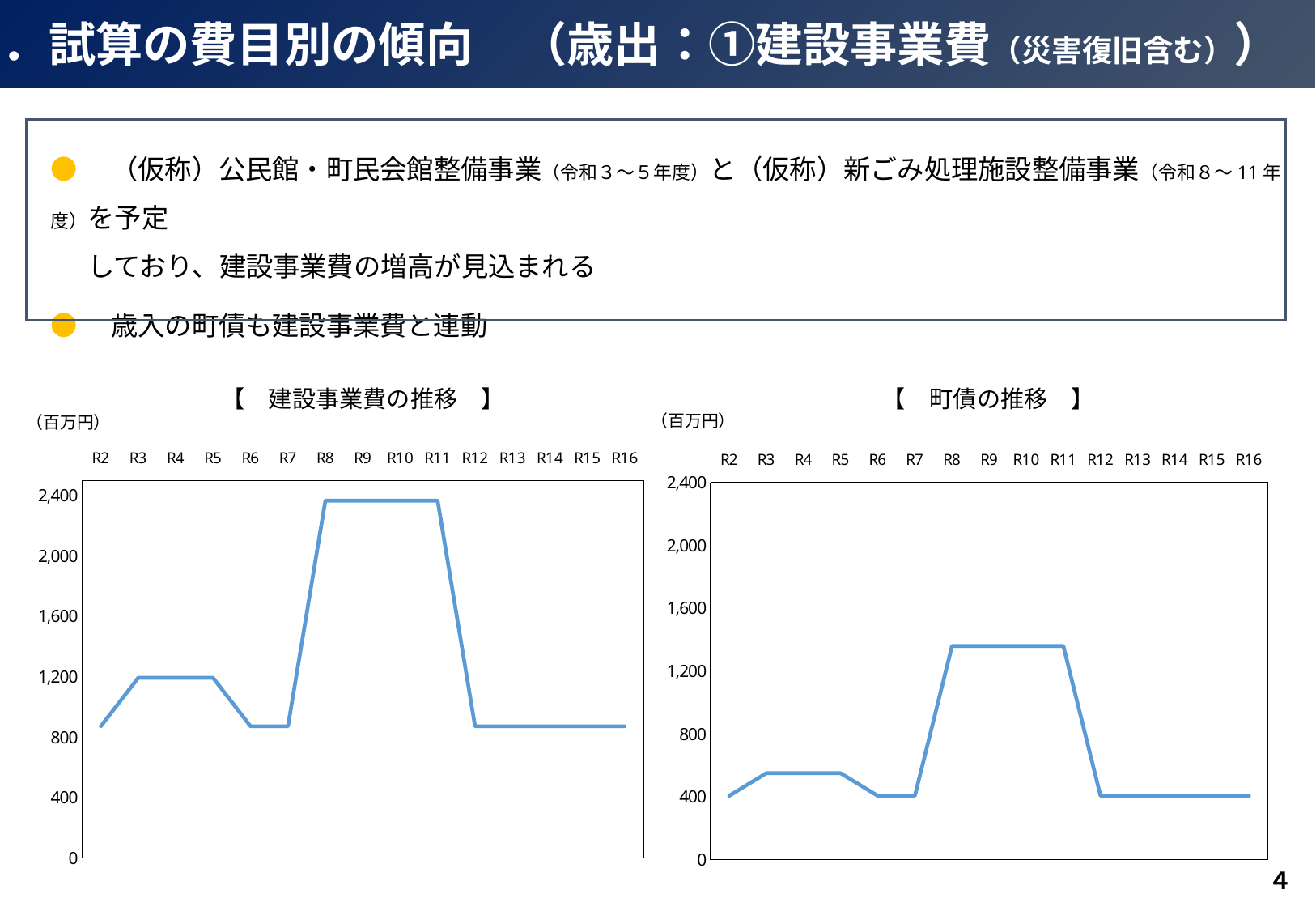
What kind of chart is the right chart titled 町債の推移? line chart In the left chart (建設事業費の推移), is the value for R2 greater or less than 1,200? less In the right chart (町債の推移), does the value rise or fall from R7 to R8? rise In the right chart (町債の推移), is the value for R14 greater or less than 800? less In the right chart (町債の推移), which is larger, the value for R4 or the value for R6? R4 What kind of chart is the left chart titled 建設事業費の推移? line chart In the left chart (建設事業費の推移), is the value for R9 greater or less than 2,000? greater In the left chart (建設事業費の推移), which is larger, the value for R4 or the value for R7? R4 In the left chart (建設事業費の推移), does the value rise or fall from R11 to R12? fall In the left chart (建設事業費の推移), how many years are plotted along the x axis? 15 What unit is shown for the values in the right chart (町債の推移)? 百万円